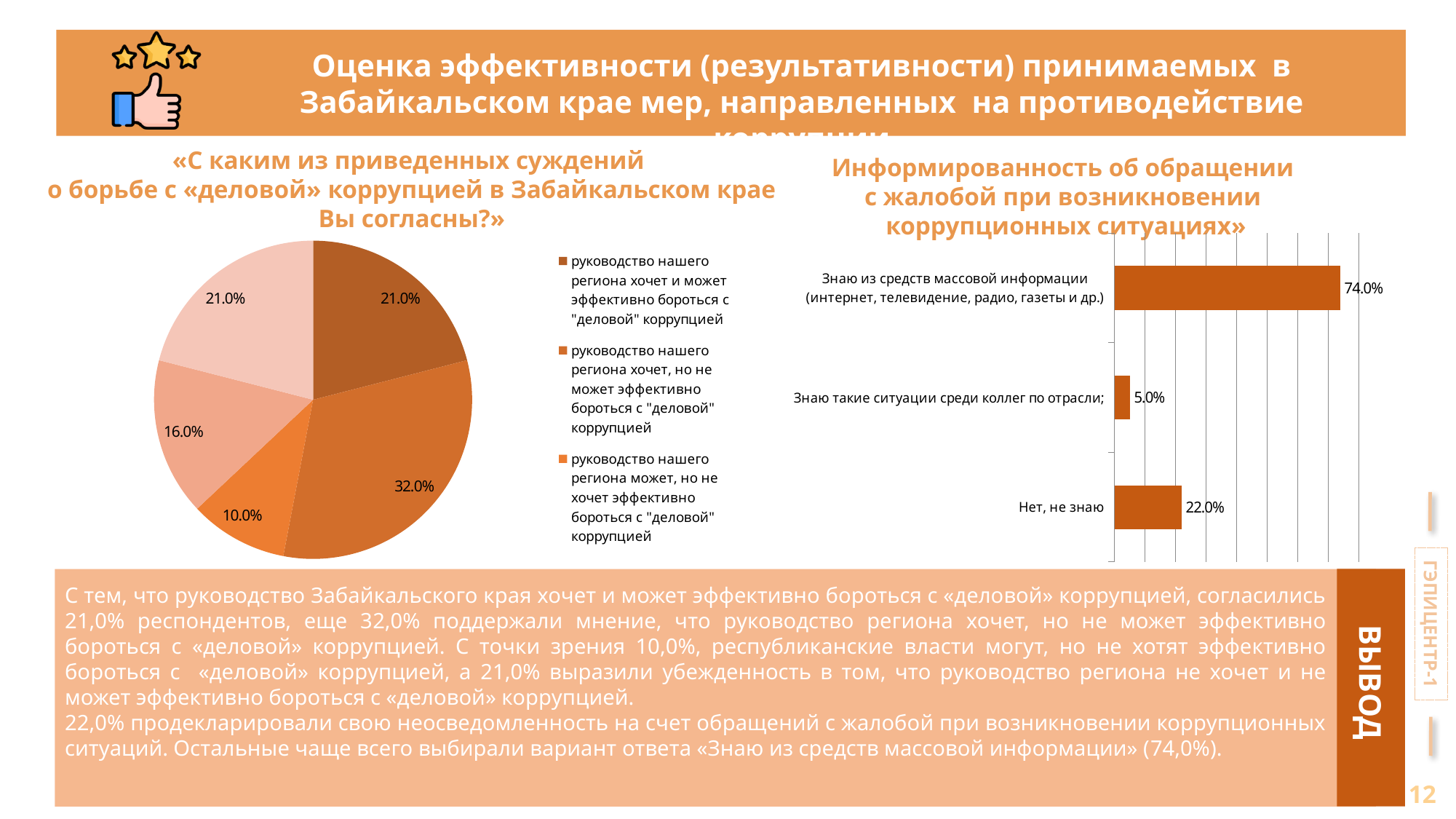
In the bar chart on the right, what is the difference between the values for «Знаю из средств массовой информации» and «Нет, не знаю»? 52.0 percentage points In the bar chart on the right, what is the value for «Знаю из средств массовой информации (интернет, телевидение, радио, газеты и др.)»? 74.0% In the bar chart on the right, what is the value for «Знаю такие ситуации среди коллег по отрасли»? 5.0% What type of chart is the chart on the right of the slide? Bar chart In the bar chart on the right, which category has the highest value? Знаю из средств массовой информации (интернет, телевидение, радио, газеты и др.) How many slices does the pie chart on the left have? 5 How many categories are shown in the bar chart on the right? 3 In the pie chart on the left, what share corresponds to «руководство нашего региона хочет, но не может эффективно бороться с "деловой" коррупцией»? 32.0% In the pie chart on the left, which legend entry has the largest slice? руководство нашего региона хочет, но не может эффективно бороться с "деловой" коррупцией In the bar chart on the right, what is the value for «Нет, не знаю»? 22.0% In the bar chart on the right, which category has the lowest value? Знаю такие ситуации среди коллег по отрасли In the pie chart on the left, what share corresponds to «руководство нашего региона может, но не хочет эффективно бороться с "деловой" коррупцией»? 10.0%